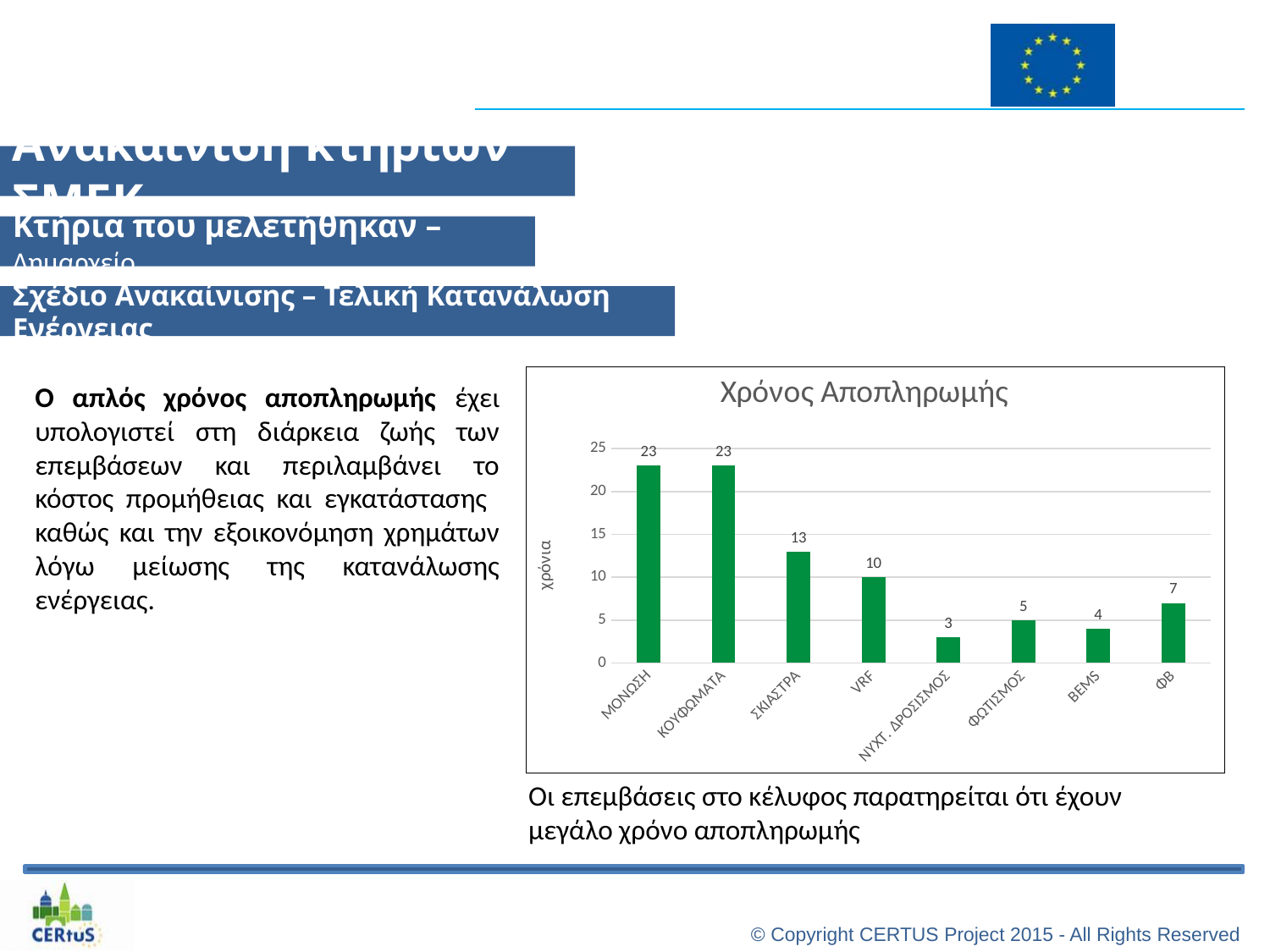
How many categories are shown on the x axis of the chart? 8 What is the value shown for ΣΚΙΑΣΤΡΑ in the chart? 13 What is the payback time (Χρόνος Αποπληρωμής) for ΜΟΝΩΣΗ? 23 Is the value for ΚΟΥΦΩΜΑΤΑ greater or less than 20? greater What is the difference between the values for ΦΩΤΙΣΜΟΣ and BEMS? 1 What is the value shown for ΦΒ? 7 What kind of chart is shown on the slide? bar chart What is the value shown for VRF? 10 Which is larger, the value for VRF or the value for ΦΒ? VRF Which category has the lowest payback time? ΝΥΧΤ. ΔΡΟΣΙΣΜΟΣ What is the difference between the values for ΜΟΝΩΣΗ and ΣΚΙΑΣΤΡΑ? 10 What is the title of the chart? Χρόνος Αποπληρωμής